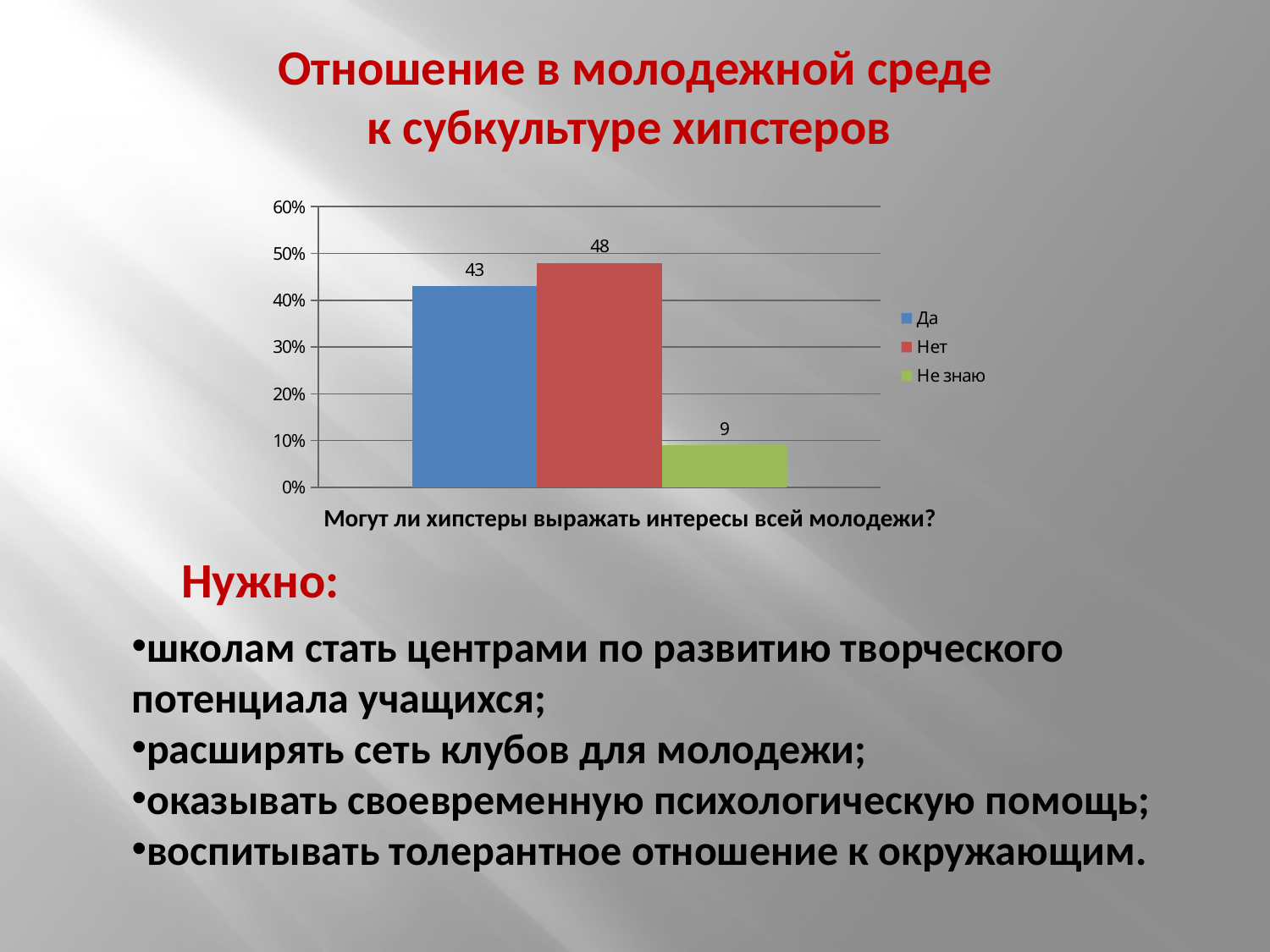
Is the value for "Не знаю" greater or less than 10%? less What value is shown for the "Нет" series? 48 What question is written below the chart's x axis? Могут ли хипстеры выражать интересы всей молодежи? What kind of chart is shown on the slide? bar chart How many series does the legend list? 3 What is the difference between the values for "Нет" and "Да"? 5 Which is larger, the value for "Да" or the value for "Нет"? Нет What value is shown for the "Не знаю" series? 9 What is the difference between the values for "Да" and "Не знаю"? 34 Which series has the highest value? Нет What value is shown for the "Да" series? 43 Which series has the lowest value? Не знаю